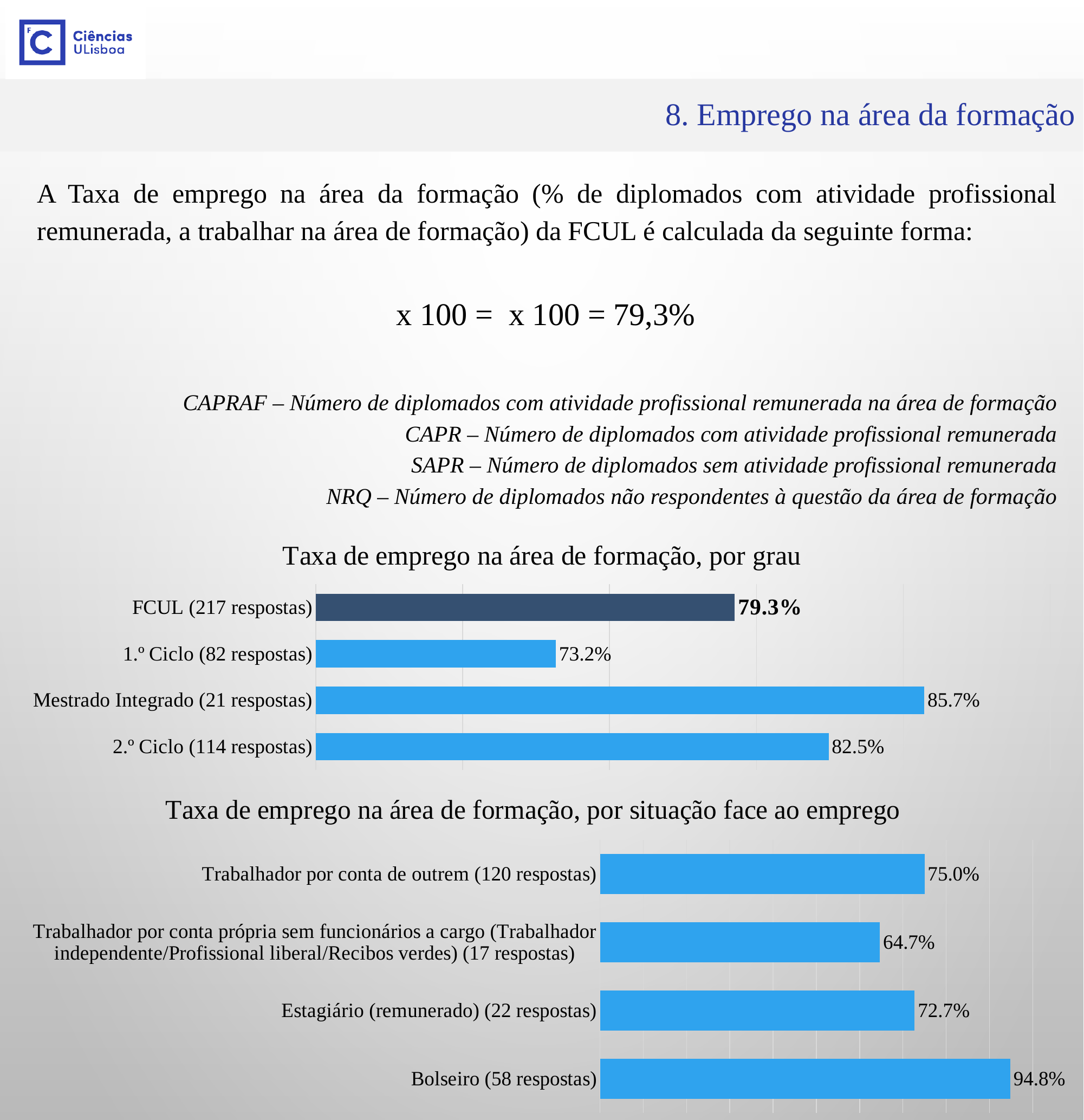
In the chart 'Taxa de emprego na área de formação, por grau', which category has the lowest value? 1.º Ciclo (82 respostas) In the chart 'Taxa de emprego na área de formação, por grau', what is the value for Mestrado Integrado (21 respostas)? 85.7% In the chart 'Taxa de emprego na área de formação, por situação face ao emprego', what is the difference between the values for Bolseiro (58 respostas) and Trabalhador por conta de outrem (120 respostas)? 19.8% In the chart 'Taxa de emprego na área de formação, por grau', what is the difference between the values for 2.º Ciclo (114 respostas) and 1.º Ciclo (82 respostas)? 9.3% In the chart 'Taxa de emprego na área de formação, por grau', what is the value for FCUL (217 respostas)? 79.3% What type of chart is 'Taxa de emprego na área de formação, por situação face ao emprego'? Bar chart In the chart 'Taxa de emprego na área de formação, por grau', how many categories are shown? 4 In the chart 'Taxa de emprego na área de formação, por situação face ao emprego', which is larger: the value for Trabalhador por conta de outrem (120 respostas) or Estagiário (remunerado) (22 respostas)? Trabalhador por conta de outrem (120 respostas) In the chart 'Taxa de emprego na área de formação, por grau', which category has the highest value? Mestrado Integrado (21 respostas) In the chart 'Taxa de emprego na área de formação, por situação face ao emprego', which category has the lowest value? Trabalhador por conta própria sem funcionários a cargo (Trabalhador independente/Profissional liberal/Recibos verdes) (17 respostas) In the chart 'Taxa de emprego na área de formação, por situação face ao emprego', what is the value for Estagiário (remunerado) (22 respostas)? 72.7% In the chart 'Taxa de emprego na área de formação, por situação face ao emprego', what is the value for Bolseiro (58 respostas)? 94.8%